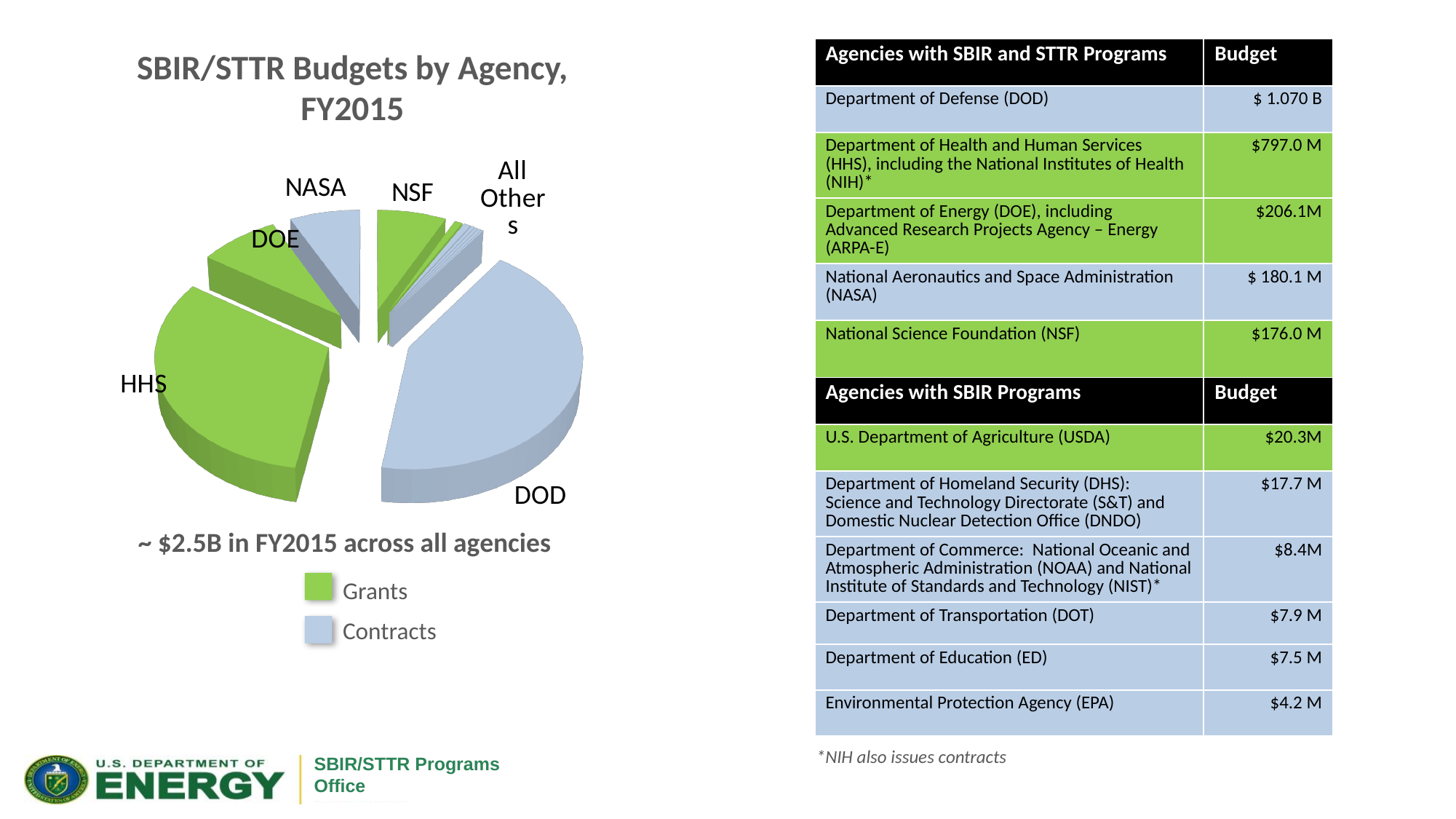
How many series does the legend list? 2 What are the two legend entries of the pie chart? Grants, Contracts What kind of chart is shown on the slide? pie chart Which slice is larger in the pie chart, DOD or NASA? DOD How many labeled slices does the pie chart have? 6 Which agency has the largest slice in the pie chart? DOD What is the title of the chart? SBIR/STTR Budgets by Agency, FY2015 Which legend category does the DOD slice belong to? Contracts Which slice is larger in the pie chart, HHS or DOE? HHS Which legend category does the HHS slice belong to? Grants Which slice is larger in the pie chart, HHS or NSF? HHS